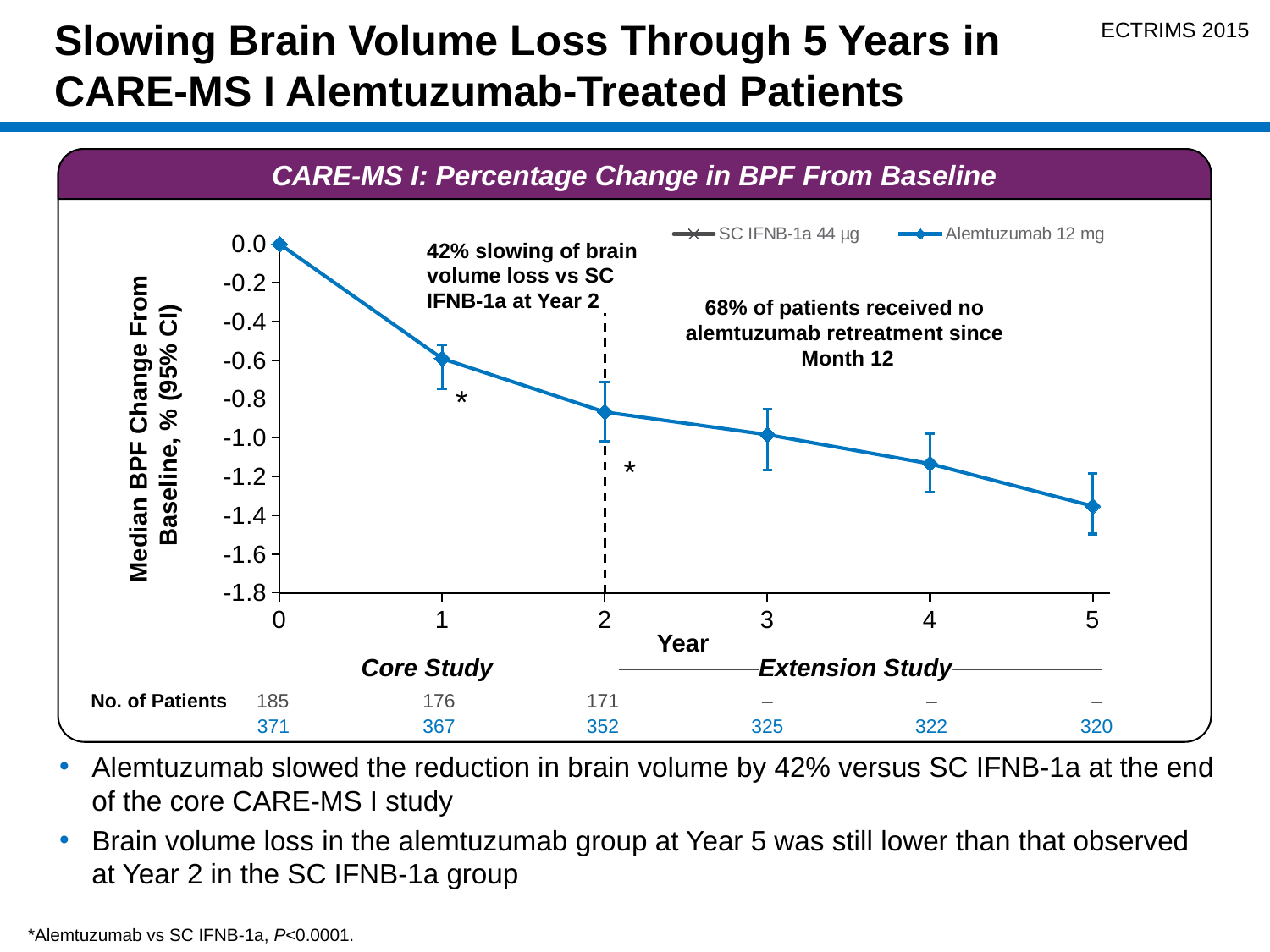
Do the Alemtuzumab 12 mg values rise or fall as the year increases? fall How many series does the chart legend list? 2 Is the Alemtuzumab 12 mg value at Year 5 greater or less than -1.2? less At which year is the Alemtuzumab 12 mg median BPF change lowest? 5 What type of chart is shown on the slide? line chart According to the No. of Patients row, how many alemtuzumab patients were there at Year 5? 320 Is the Alemtuzumab 12 mg value at Year 3 greater or less than -1.2? greater What is the median BPF change from baseline for Alemtuzumab 12 mg at Year 0? 0.0 What is the title of the chart? CARE-MS I: Percentage Change in BPF From Baseline How many data points are plotted for Alemtuzumab 12 mg? 6 Which is larger, the Alemtuzumab 12 mg value at Year 1 or at Year 4? Year 1 Is the Alemtuzumab 12 mg value at Year 1 greater or less than -0.8? greater